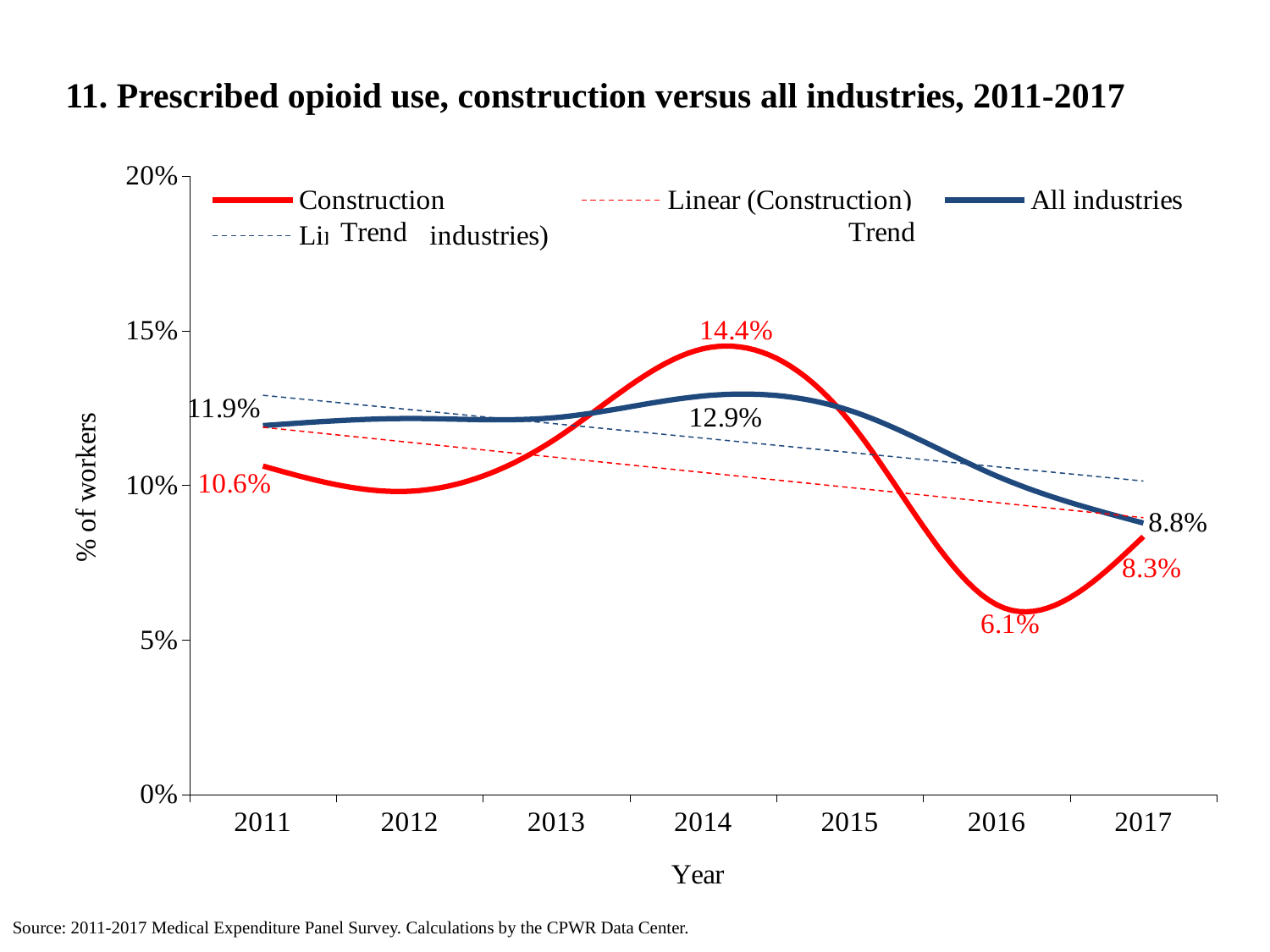
In 2017, which series has the larger value, Construction or All industries? All industries What kind of chart is shown on the slide? line chart What is the value for Construction in 2014? 14.4% In which year does the Construction series reach its lowest value? 2016 Is the value for All industries in 2015 greater or less than 10%? greater What is the value for All industries in 2011? 11.9% Does the Construction series rise or fall between 2014 and 2016? fall How many years are shown on the x axis? 7 What is the difference between the Construction values in 2014 and 2011? 3.8% In which year does the Construction series reach its highest value? 2014 What is the value for Construction in 2016? 6.1% What is the value for All industries in 2017? 8.8%